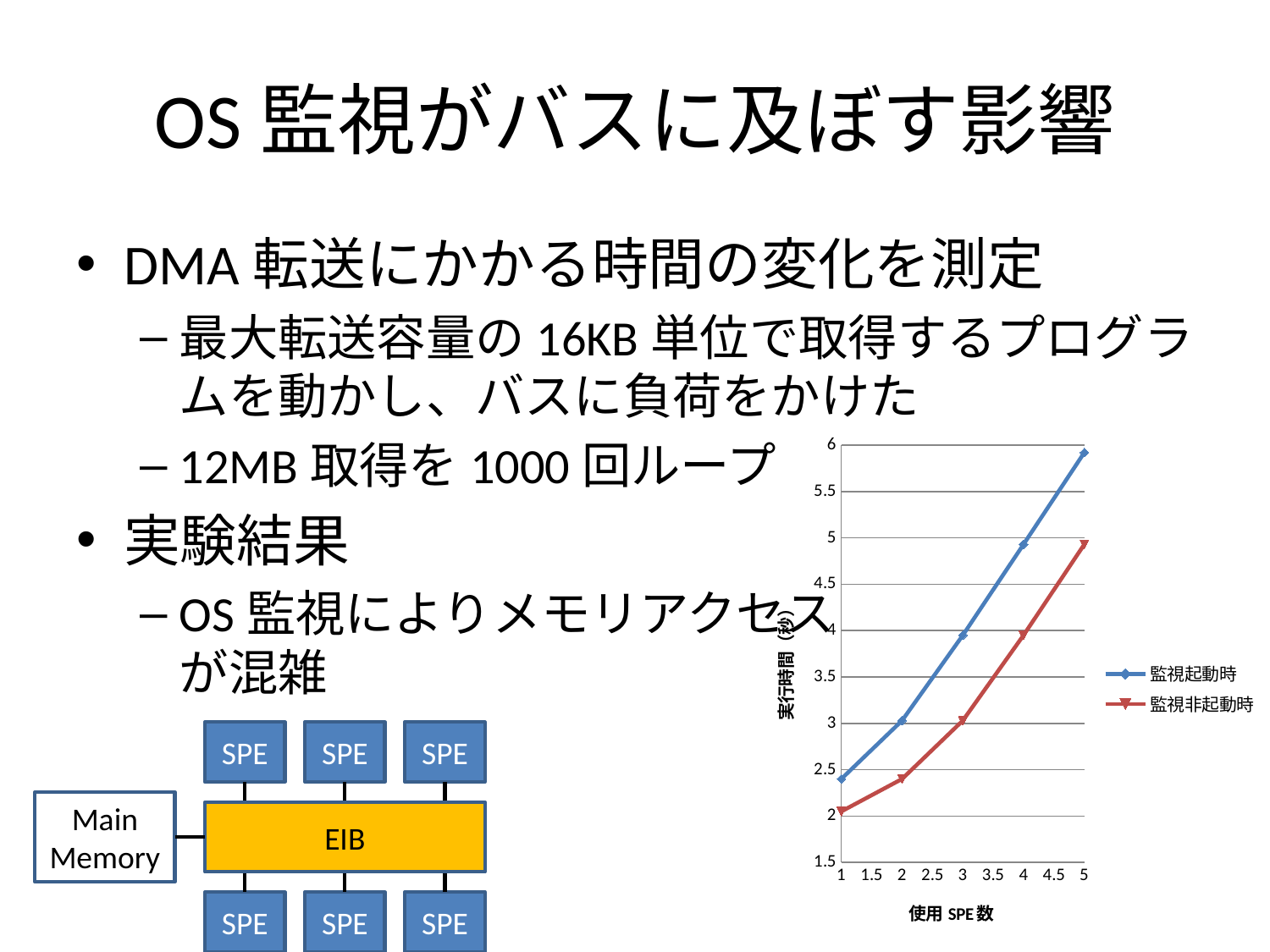
Is the value for 監視非起動時 at 4 SPEs greater or less than 3.5? greater Is the value for 監視起動時 at 4 SPEs greater or less than 4.5? greater Does the execution time for 監視起動時 rise or fall as the number of SPEs increases? rise What kind of chart is shown on the slide? line chart At 3 SPEs, which series has the higher execution time, 監視起動時 or 監視非起動時? 監視起動時 What is the label of the x axis of the chart? 使用 SPE 数 Does the execution time for 監視非起動時 rise or fall as the number of SPEs increases? rise How many series does the chart legend list? 2 Is the value for 監視非起動時 at 2 SPEs greater or less than 3? less How many data points does each series in the chart have? 5 At which number of SPEs is the execution time for 監視起動時 highest? 5